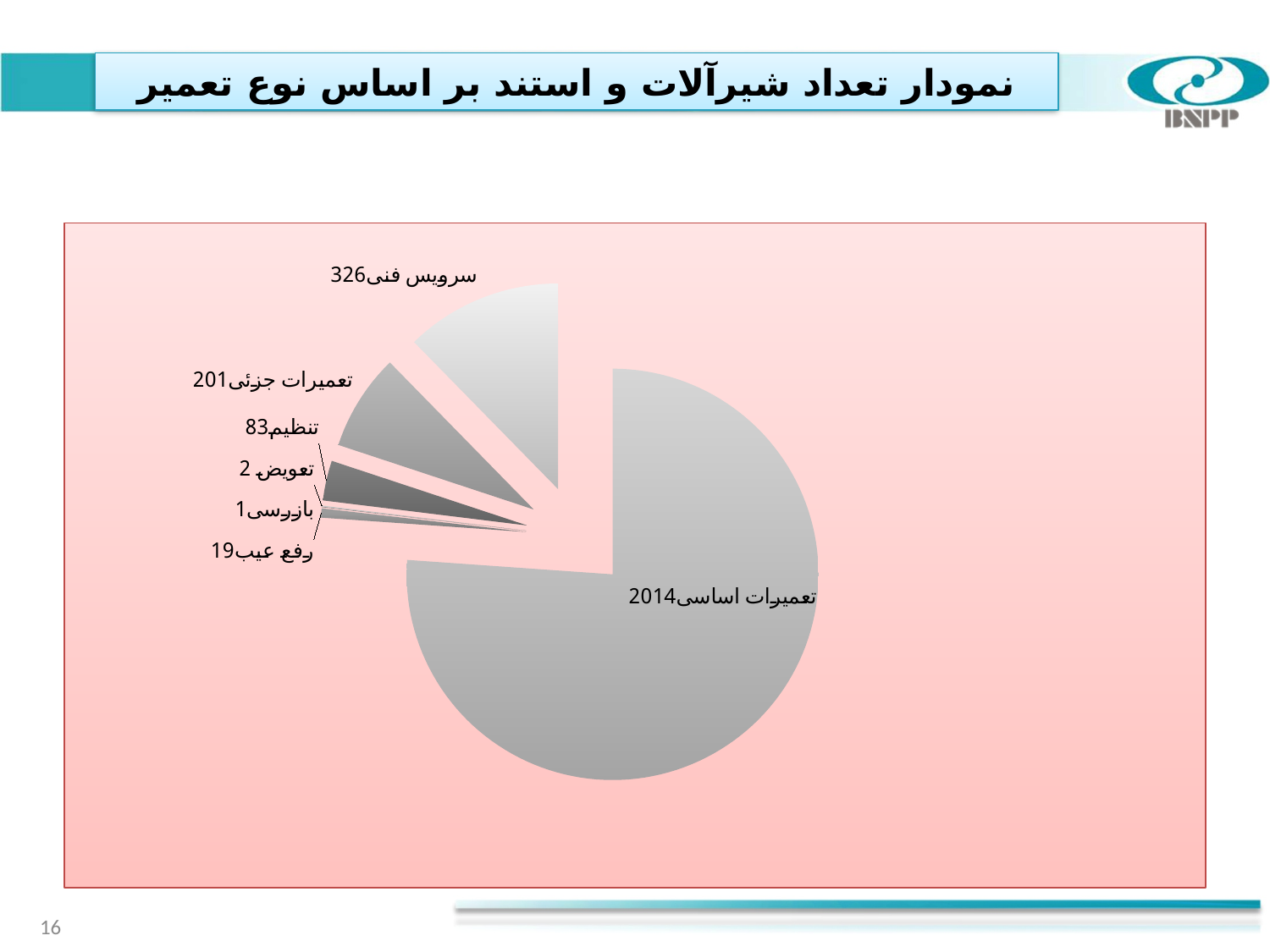
What type of chart is shown on the slide? pie chart What is the value for سرویس فنی in the pie chart? 326 Which category has the largest slice in the pie chart? تعمیرات اساسی What is the title of the slide containing the pie chart? نمودار تعداد شیرآلات و استند بر اساس نوع تعمیر How many categories (slices) does the pie chart have? 7 What is the value for تعمیرات جزئی in the pie chart? 201 Which category has the smallest slice in the pie chart? بازرسی What is the difference between the values for سرویس فنی and تعمیرات جزئی? 125 Which is larger, the value for تنظیم or the value for رفع عیب? تنظیم What is the value for تنظیم in the pie chart? 83 What is the value for تعمیرات اساسی in the pie chart? 2014 What is the value for رفع عیب in the pie chart? 19